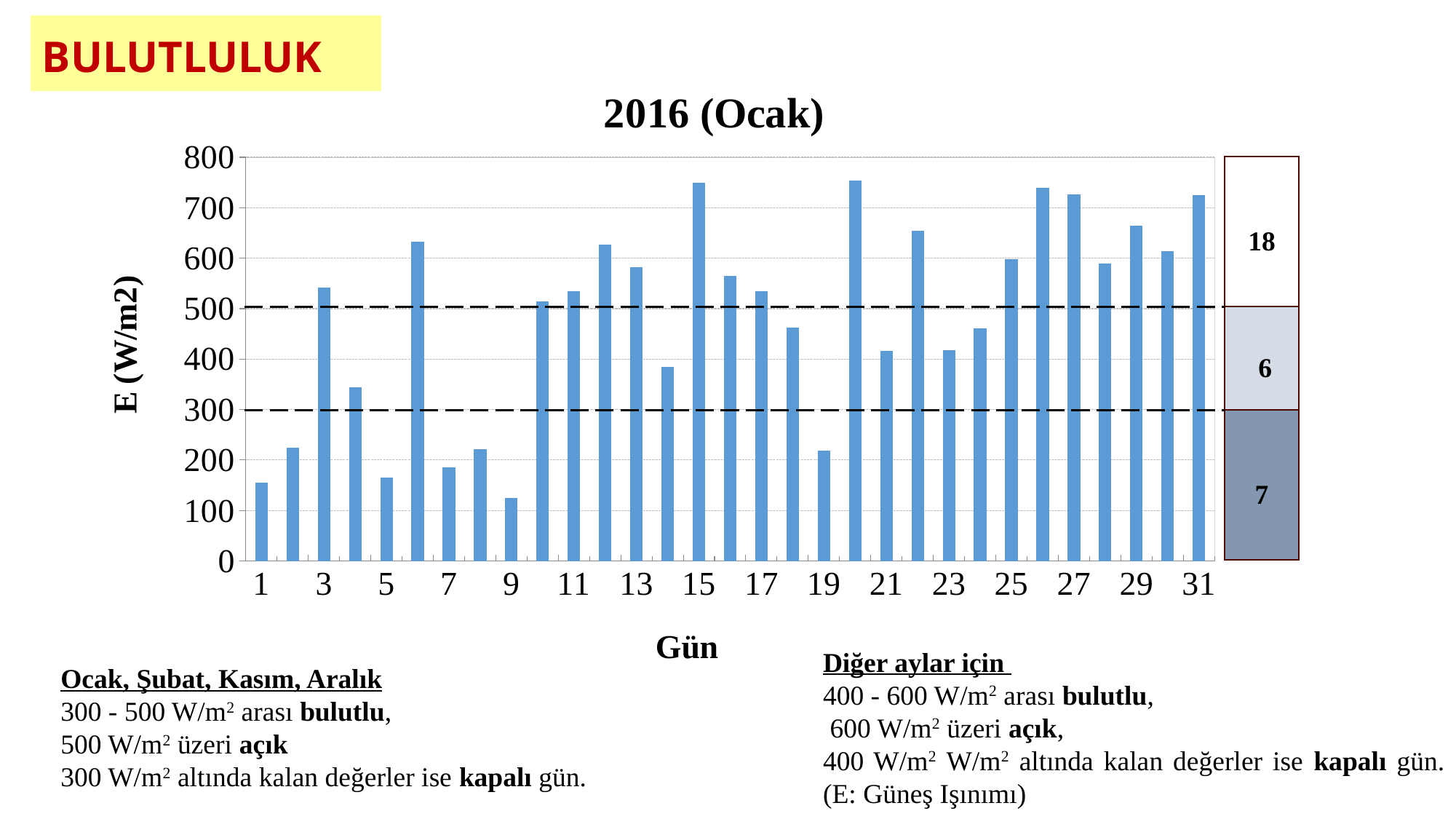
Is the value for day 3 greater or less than 500? greater Which day has the lowest value on the chart? 9 How many days (bars) are plotted on the chart? 31 Which has the larger value, day 20 or day 21? day 20 Is the value for day 1 greater or less than 200? less Is the value for day 15 greater or less than 700? greater What kind of chart is shown on the slide? bar chart What is the label of the vertical axis of the chart? E (W/m2) Which has the larger value, day 14 or day 15? day 15 What is the title of the chart? 2016 (Ocak)